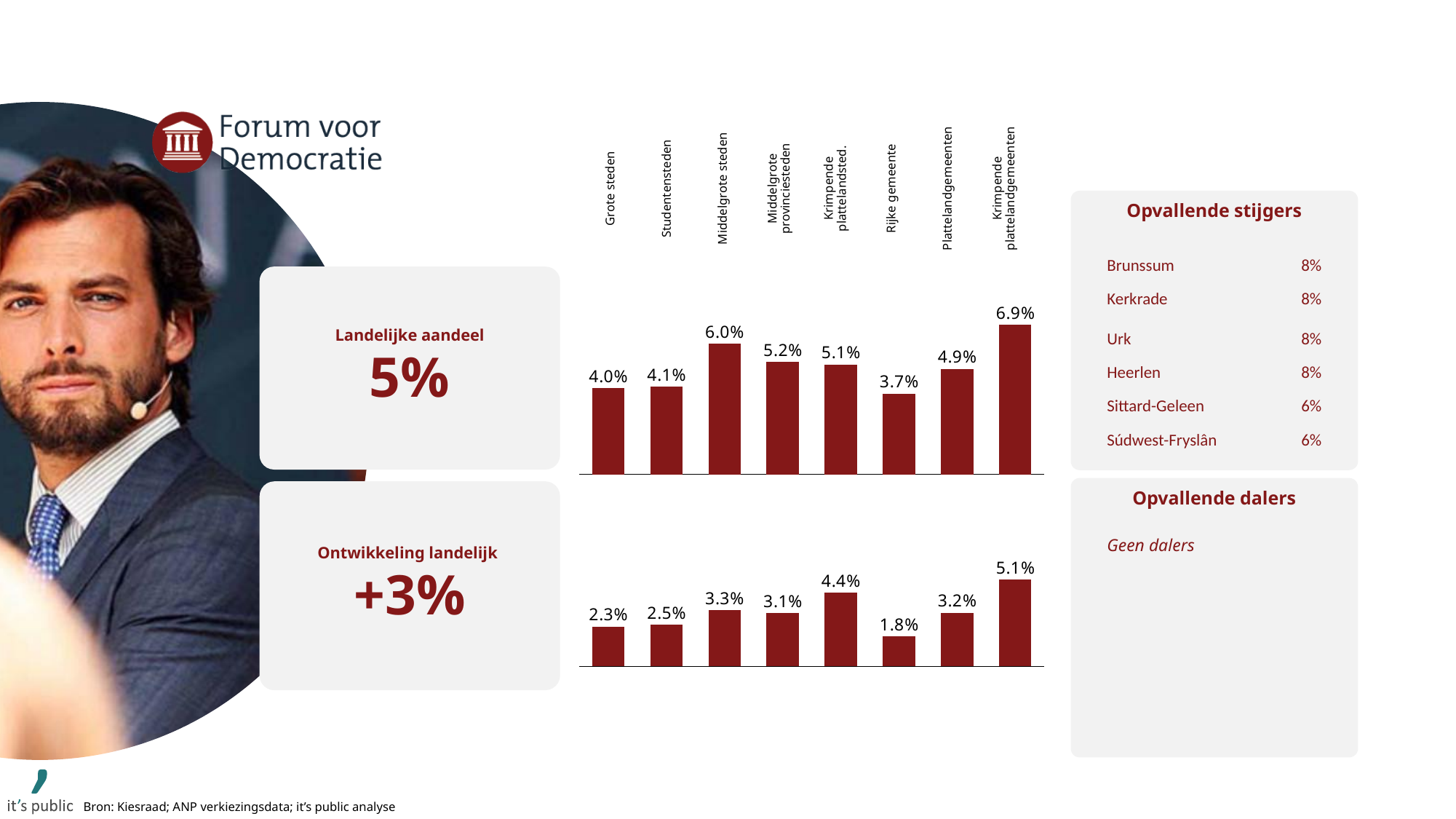
In the top chart (Landelijke aandeel), what is the value for Middelgrote steden? 6.0% In the bottom chart (Ontwikkeling landelijk), what is the value for Krimpende plattelandsted.? 4.4% How many categories does the top chart (Landelijke aandeel) show? 8 In the bottom chart (Ontwikkeling landelijk), which is larger: Middelgrote steden or Plattelandgemeenten? Middelgrote steden In the top chart (Landelijke aandeel), what is the difference between Krimpende plattelandgemeenten and Grote steden? 2.9% In the bottom chart (Ontwikkeling landelijk), which category has the lowest value? Rijke gemeente In the bottom chart (Ontwikkeling landelijk), what is the difference between Krimpende plattelandgemeenten and Rijke gemeente? 3.3% In the top chart (Landelijke aandeel), which category has the highest value? Krimpende plattelandgemeenten In the top chart (Landelijke aandeel), which category has the lowest value? Rijke gemeente What kind of chart is the top chart (Landelijke aandeel)? Bar chart In the top chart (Landelijke aandeel), what is the value for Plattelandgemeenten? 4.9% In the bottom chart (Ontwikkeling landelijk), which category has the highest value? Krimpende plattelandgemeenten